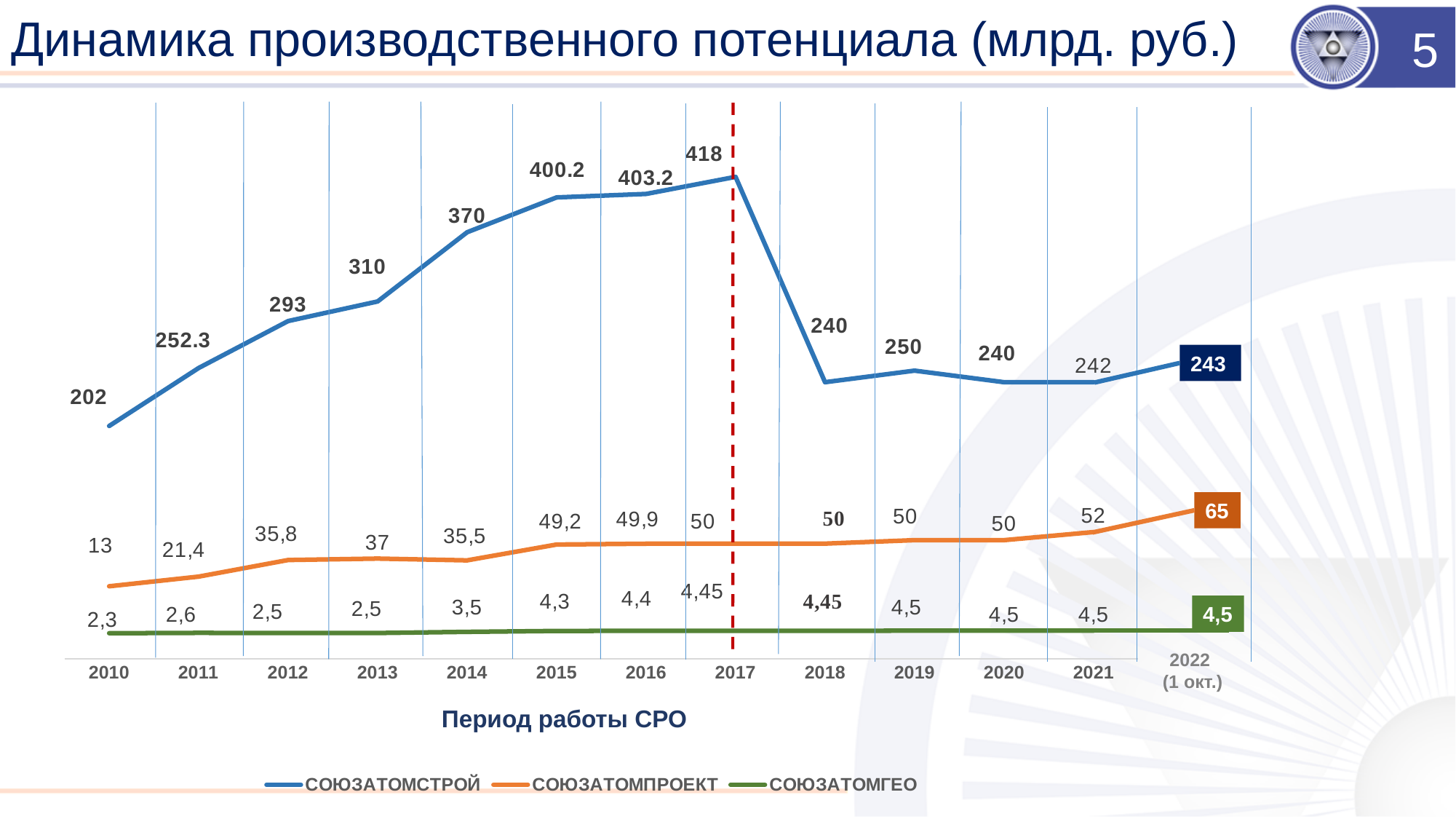
In which year is the value for СОЮЗАТОМПРОЕКТ lowest? 2010 What is the value for СОЮЗАТОМПРОЕКТ in 2022 (1 окт.)? 65 What kind of chart is shown on the slide? line chart What is the value for СОЮЗАТОМСТРОЙ in 2017? 418 Which is larger, the СОЮЗАТОМПРОЕКТ value in 2013 or in 2014? 2013 How many series does the legend list? 3 What is the value for СОЮЗАТОМГЕО in 2014? 3,5 How many points along the x axis does each line have? 13 What is the x-axis title of the chart? Период работы СРО In which year does СОЮЗАТОМСТРОЙ reach its highest value? 2017 Does the СОЮЗАТОМСТРОЙ line rise or fall from 2010 to 2017? rise What is the difference between the СОЮЗАТОМСТРОЙ values in 2017 and 2018? 178